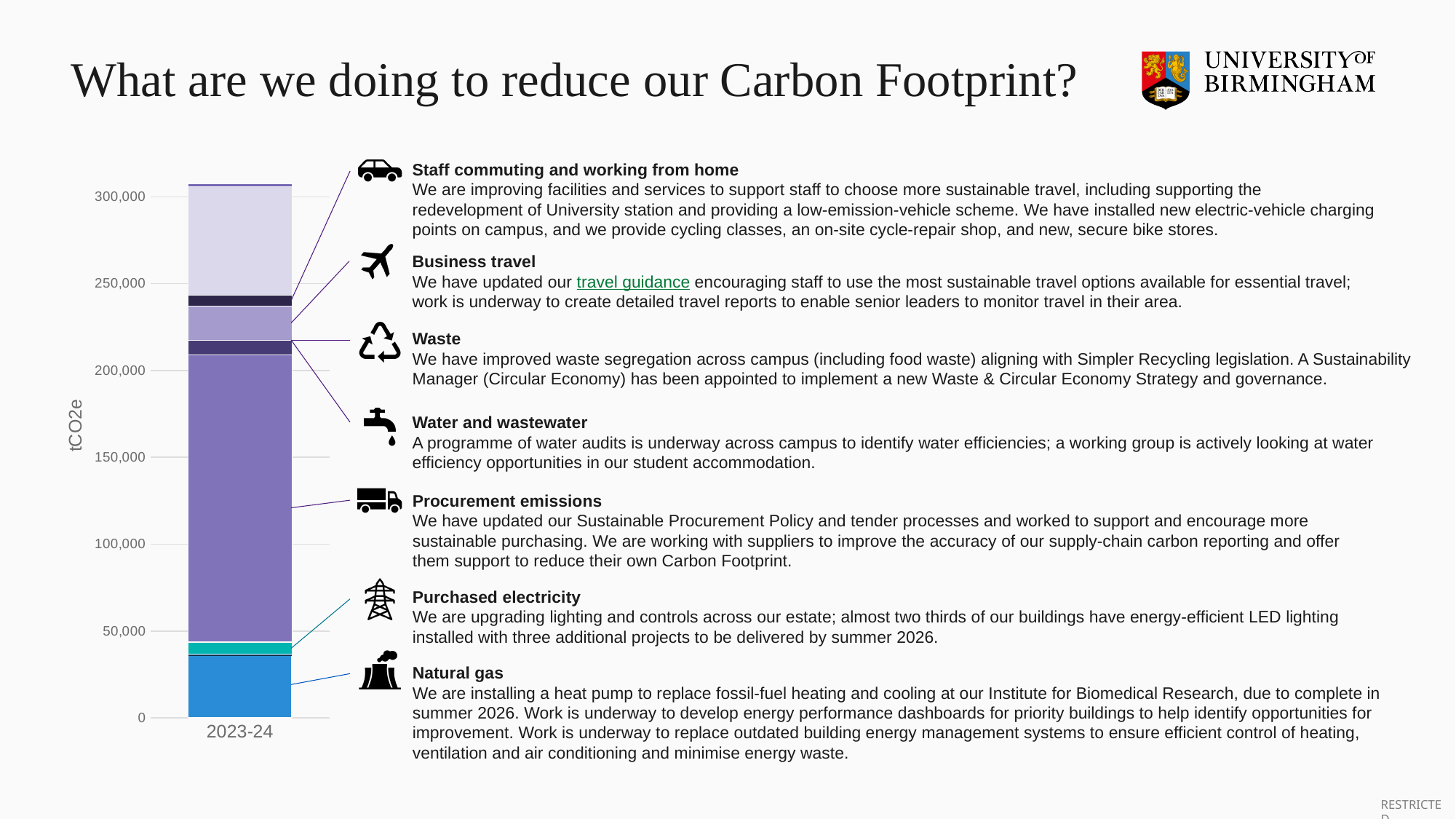
What kind of chart is shown on the slide? Stacked bar chart Is the Procurement emissions segment of the 2023-24 bar greater or less than 150,000 tCO2e? greater Which year label appears on the x axis of the chart? 2023-24 Which emission source is the largest segment of the 2023-24 bar? Procurement emissions Which emission source is at the bottom of the 2023-24 stacked bar? Natural gas Is the Natural gas segment of the 2023-24 bar greater or less than 50,000 tCO2e? less Which is larger in the 2023-24 bar, the Procurement emissions segment or the Purchased electricity segment? Procurement emissions How many categories are shown on the x axis of the chart? 1 Is the total height of the 2023-24 bar greater or less than 300,000 tCO2e? greater What is the label on the y axis of the chart? tCO2e